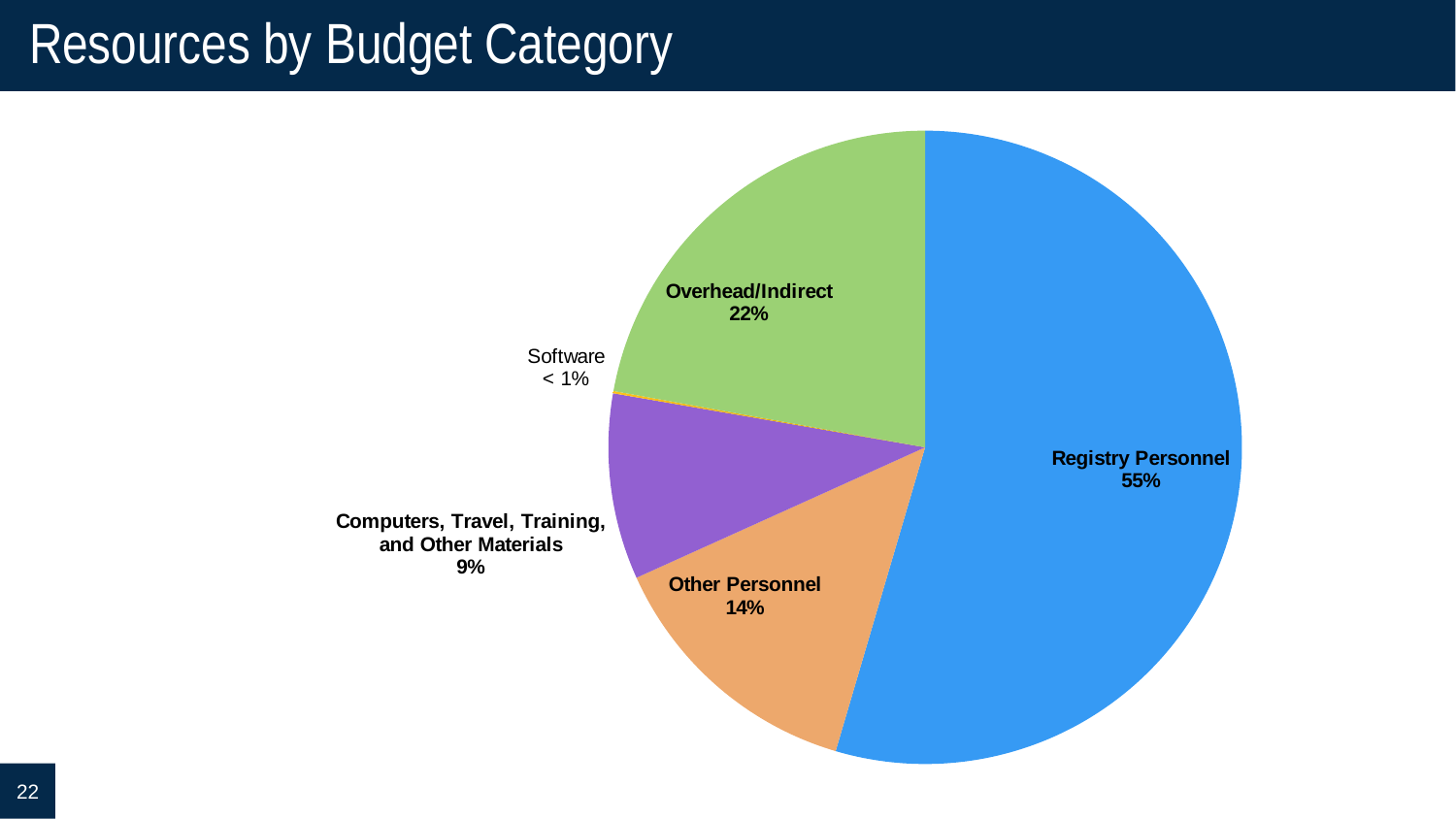
What share of the budget goes to Overhead/Indirect? 22% Which budget category has the smallest share? Software What is the difference in share between Registry Personnel and Overhead/Indirect? 33% What share of the budget is labelled for Software? < 1% What share of the budget goes to Computers, Travel, Training, and Other Materials? 9% What kind of chart is shown on the slide? pie chart Which budget category has the largest share? Registry Personnel Which has a larger share, Other Personnel or Overhead/Indirect? Overhead/Indirect How many slices does the pie chart have? 5 What is the title of the slide containing the pie chart? Resources by Budget Category